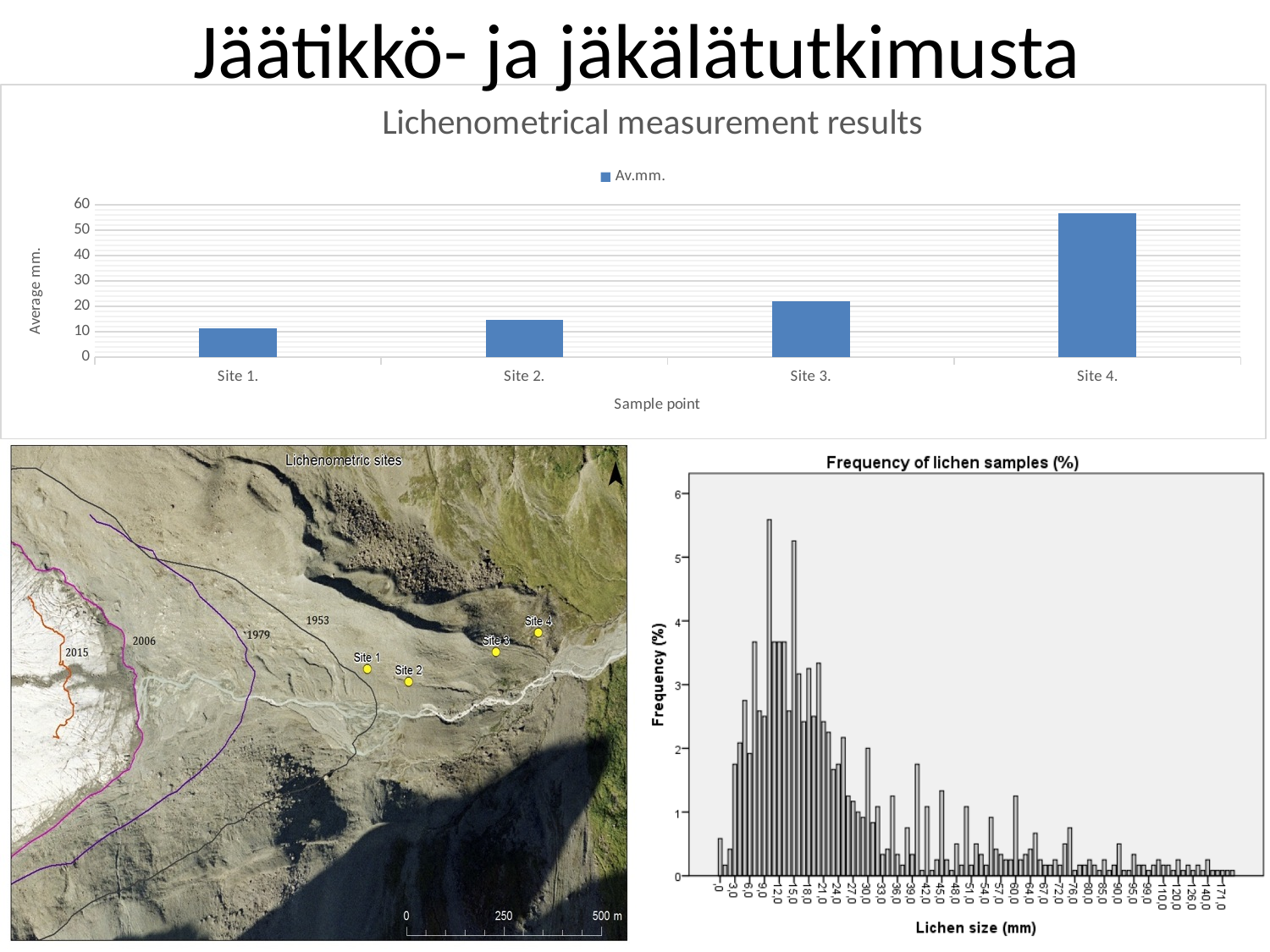
In the chart titled 'Lichenometrical measurement results', is the value for Site 4. greater or less than 50? greater In the chart titled 'Lichenometrical measurement results', how many sample points are shown on the x axis? 4 In the chart titled 'Lichenometrical measurement results', is the value for Site 1. greater or less than 20? less In the chart titled 'Lichenometrical measurement results', what kind of chart is used? bar chart In the chart titled 'Lichenometrical measurement results', which has a larger value, Site 2. or Site 3.? Site 3. What is the title of the chart at the bottom right of the slide? Frequency of lichen samples (%) In the chart titled 'Lichenometrical measurement results', is the value for Site 3. greater or less than 30? less In the chart titled 'Lichenometrical measurement results', what is the legend entry for the series? Av.mm. In the chart titled 'Lichenometrical measurement results', how many series does the legend list? 1 In the chart titled 'Lichenometrical measurement results', do the values rise or fall from Site 1. to Site 4.? rise In the chart titled 'Lichenometrical measurement results', which sample point has the highest average mm? Site 4. In the chart titled 'Lichenometrical measurement results', which sample point has the lowest average mm? Site 1.